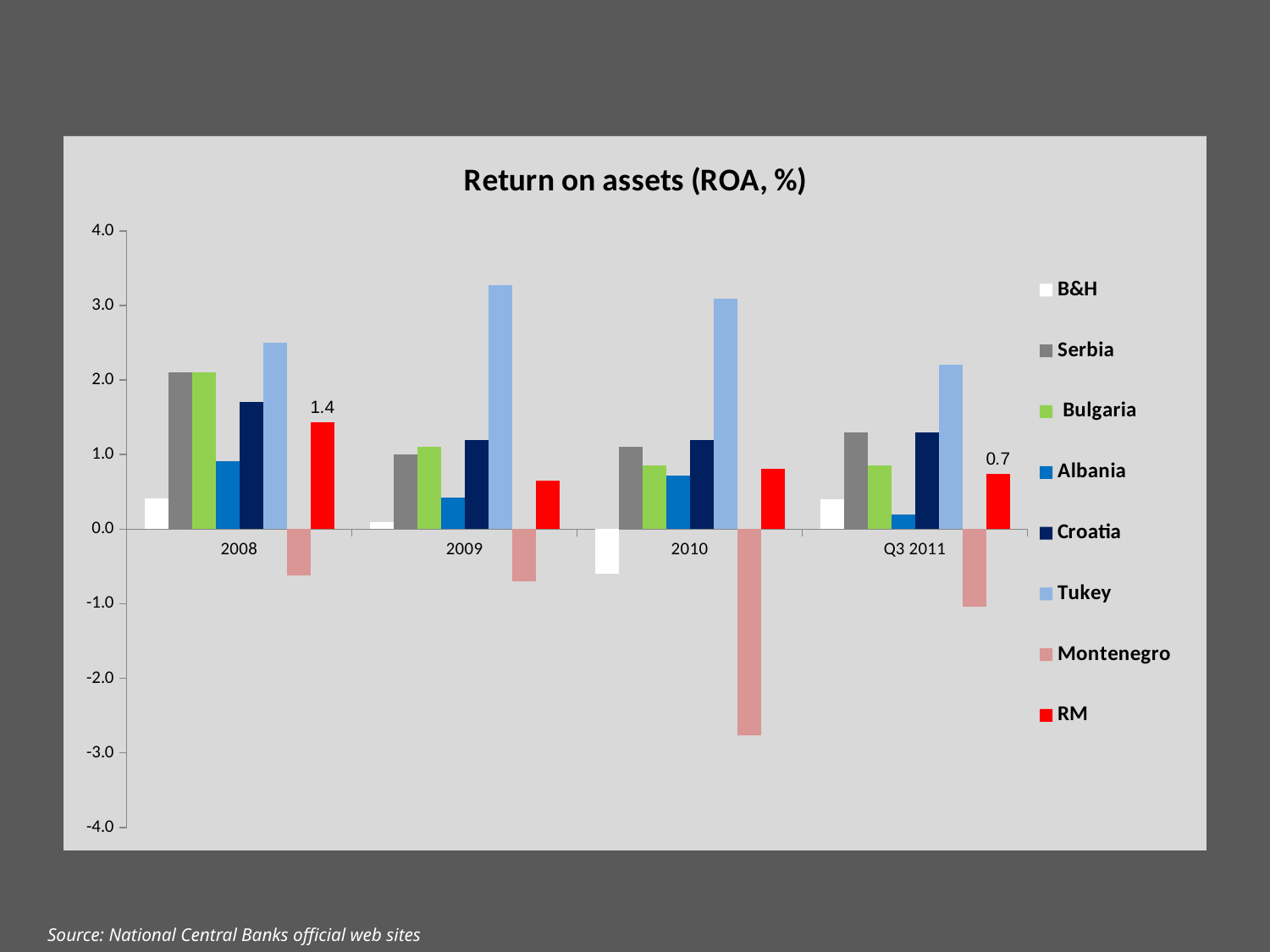
Is the value for Montenegro in 2010 greater or less than -2.0? less What is the title of the chart? Return on assets (ROA, %) What kind of chart is shown on the slide? bar chart How many series does the legend list? 8 Is the value for Tukey in 2009 greater or less than 3.0? greater By how much did the ROA for RM fall from 2008 to Q3 2011? 0.7 What is the ROA value for RM in 2008? 1.4 What is the ROA value for RM in Q3 2011? 0.7 How many time periods are shown on the x axis? 4 Which is larger, the ROA for Serbia in 2008 or in 2009? 2008 Which country has the highest ROA in 2009? Tukey Which country has the lowest ROA in 2010? Montenegro